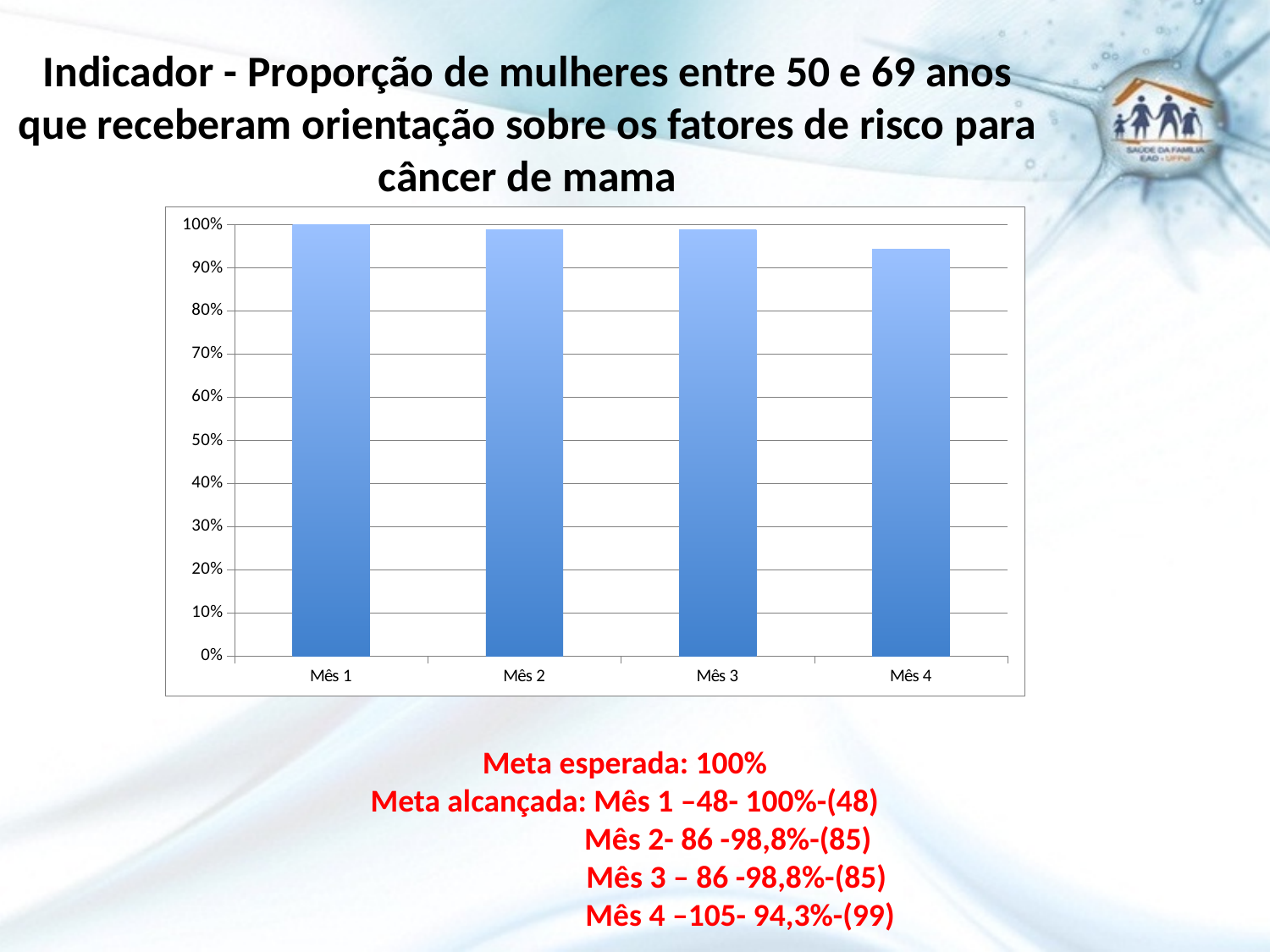
Is the value for Mês 2 greater or less than 90%? greater Which is larger, the value for Mês 1 or the value for Mês 4? Mês 1 What is the highest value shown on the y axis? 100% What kind of chart is shown on the slide? bar chart What is the 'Meta esperada' stated below the chart? 100% Do the values generally rise or fall from Mês 1 to Mês 4? fall How many months (categories) are plotted on the x axis? 4 Is the value for Mês 4 greater or less than 100%? less What is the value for Mês 1? 100% Is the value for Mês 3 greater or less than 80%? greater Which month has the lowest bar? Mês 4